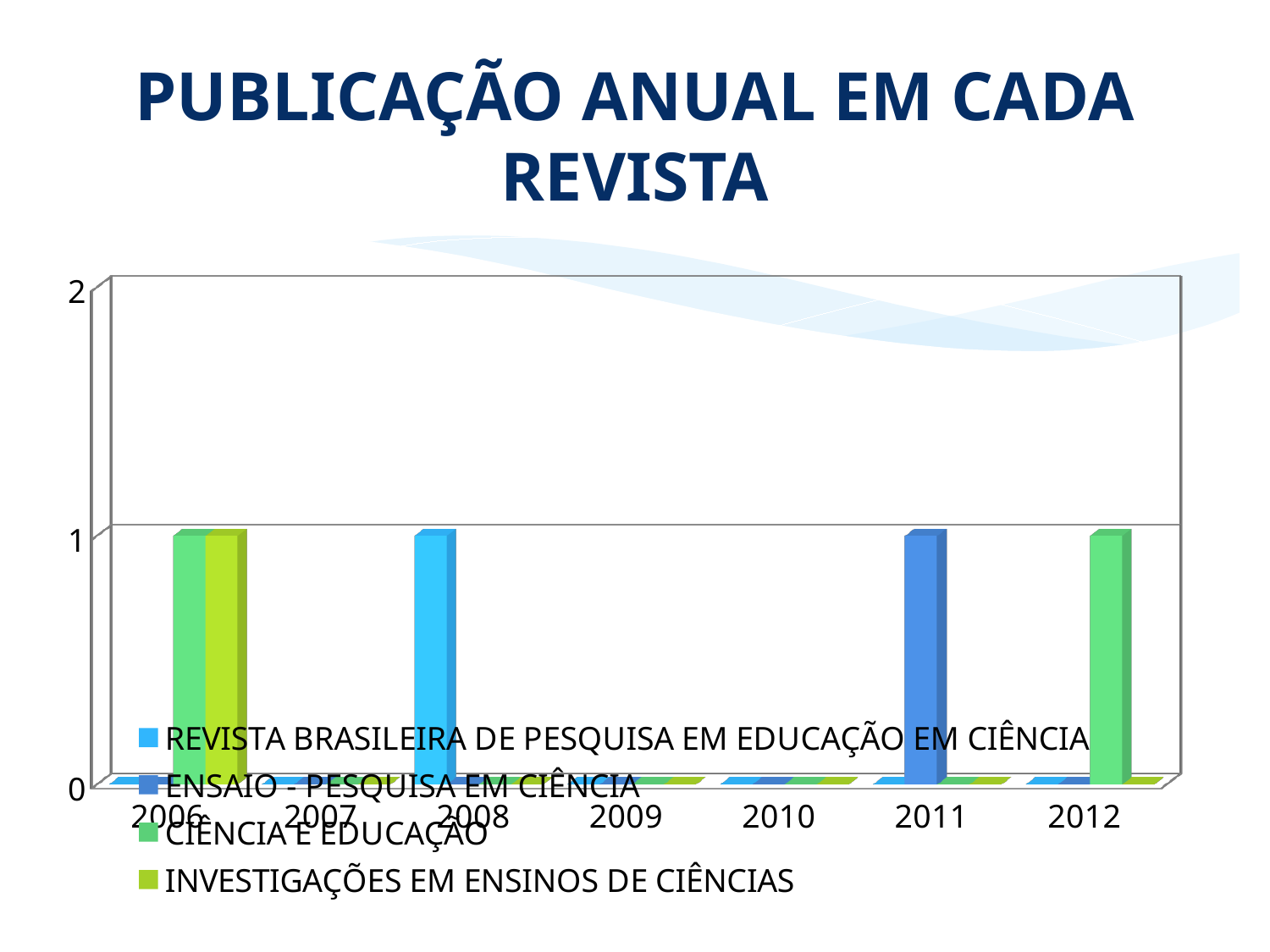
Which is larger, the value for ENSAIO - PESQUISA EM CIÊNCIA in 2011 or in 2010? 2011 What is the title of the chart? PUBLICAÇÃO ANUAL EM CADA REVISTA What is the value for CIÊNCIA E EDUCAÇÃO in 2009? 0 What is the value for INVESTIGAÇÕES EM ENSINOS DE CIÊNCIAS in 2006? 1 What is the value for CIÊNCIA E EDUCAÇÃO in 2012? 1 What kind of chart is shown on the slide? bar chart What is the value for ENSAIO - PESQUISA EM CIÊNCIA in 2011? 1 How many series does the legend list? 4 How many years are shown on the x axis? 7 What is the value for CIÊNCIA E EDUCAÇÃO in 2006? 1 What is the highest value shown on the vertical axis? 2 What is the value for REVISTA BRASILEIRA DE PESQUISA EM EDUCAÇÃO EM CIÊNCIA in 2008? 1